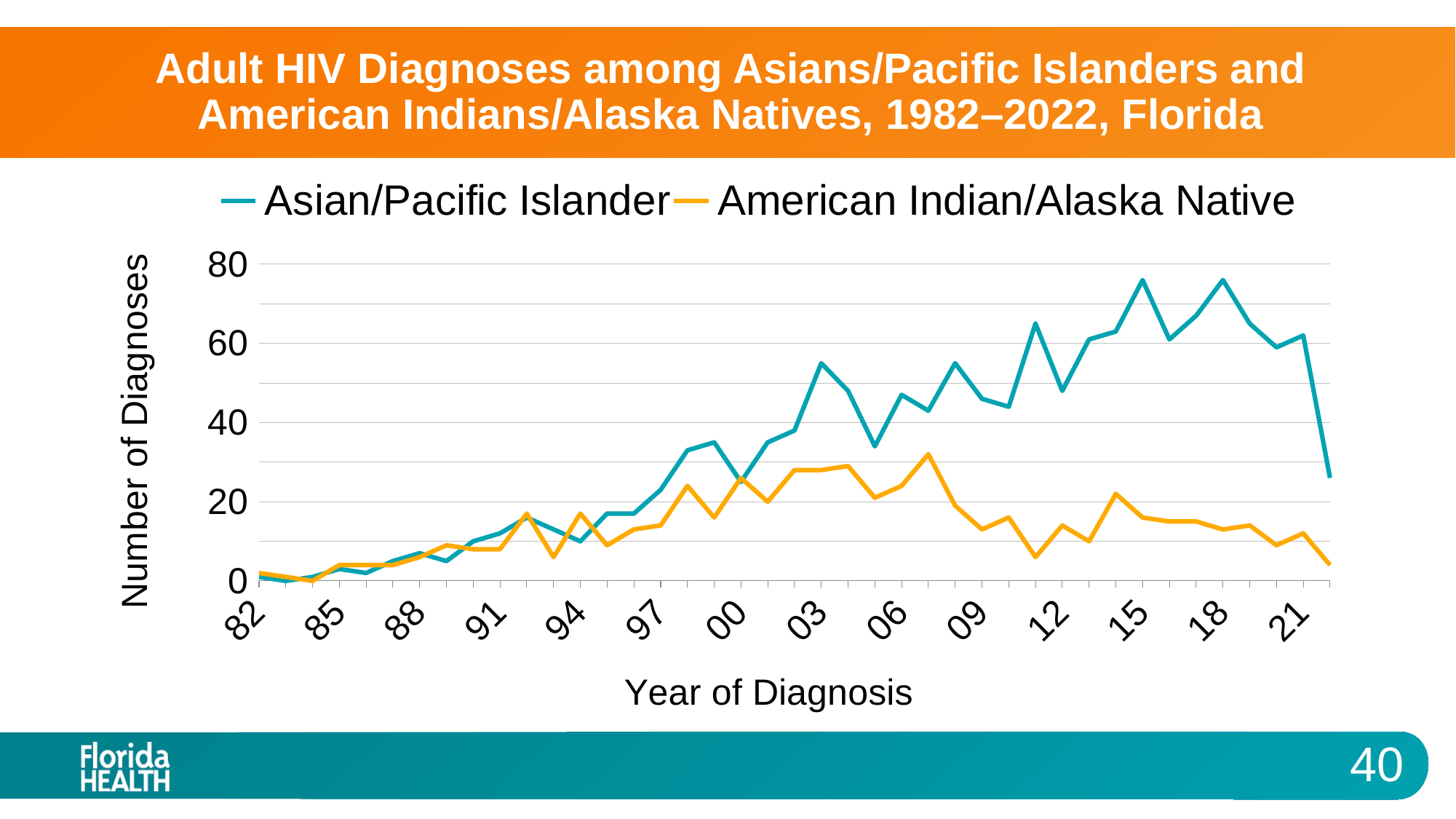
Is the value for American Indian/Alaska Native in 2007 greater or less than 20? greater What are the two series named in the legend? Asian/Pacific Islander and American Indian/Alaska Native Which series reaches the highest number of diagnoses on the chart? Asian/Pacific Islander Does the Asian/Pacific Islander line rise or fall from 2021 to 2022? Fall What kind of chart is shown on the slide? Line chart How many series does the legend list? 2 In 2018, which series has the higher number of diagnoses? Asian/Pacific Islander Is the value for Asian/Pacific Islander in 2022 greater or less than 40? less What is the label on the y axis? Number of Diagnoses Is the value for American Indian/Alaska Native in 2022 greater or less than 20? less How many years of diagnosis does the chart cover, from 1982 to 2022? 41